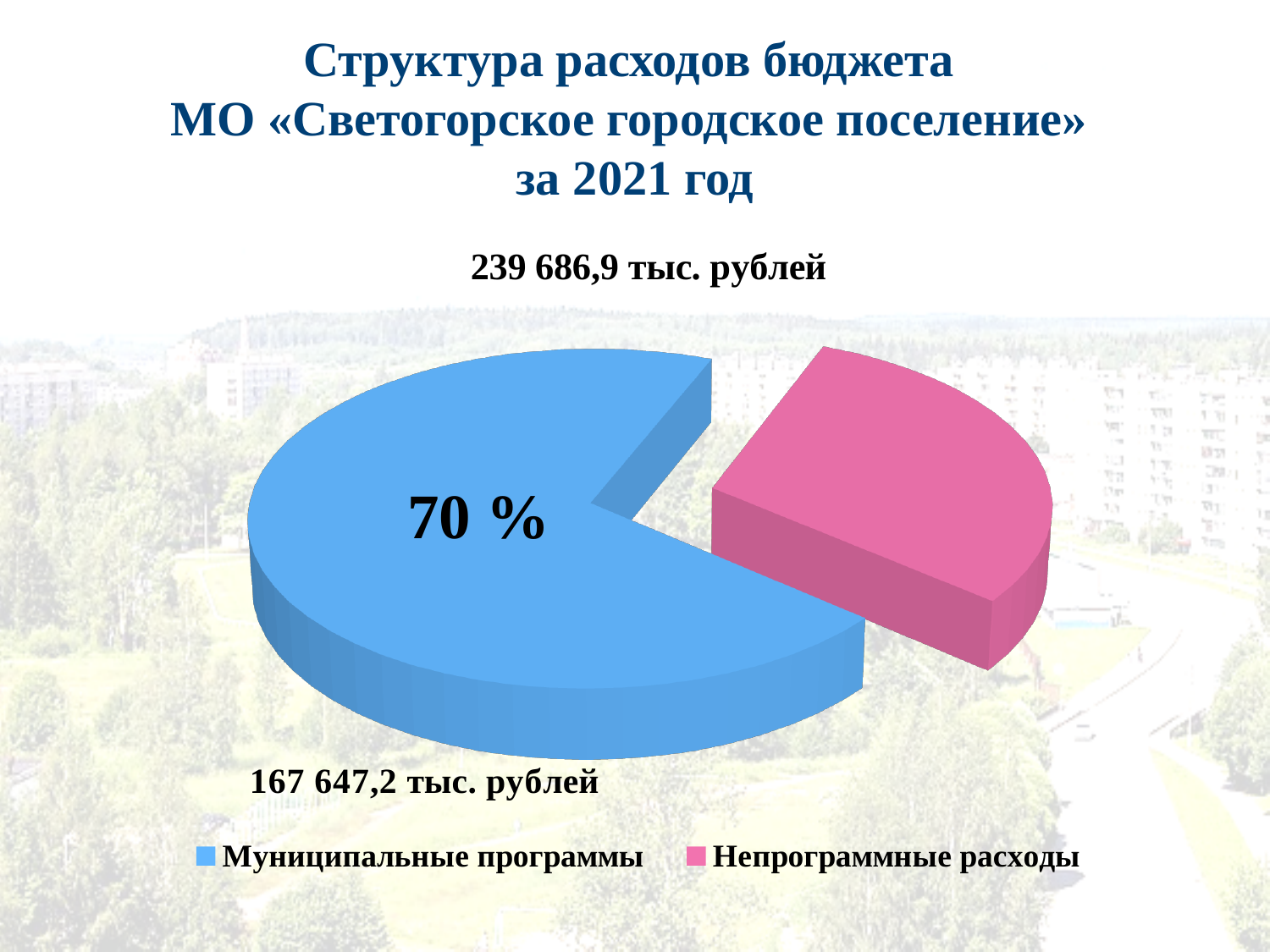
What total amount is shown above the pie chart? 239 686,9 тыс. рублей What share of the pie does Муниципальные программы take? 70 % What is the difference between the total 239 686,9 тыс. рублей and the value for Муниципальные программы? 72 039,7 тыс. рублей How many entries does the legend list? 2 What value is shown for Муниципальные программы? 167 647,2 тыс. рублей Which category has the largest slice of the pie? Муниципальные программы Which year does the chart title refer to? 2021 What colour is the slice for Непрограммные расходы? pink Which category has the smallest slice of the pie? Непрограммные расходы How many slices does the pie chart have? 2 Which is larger, Муниципальные программы or Непрограммные расходы? Муниципальные программы What kind of chart is shown on the slide? pie chart